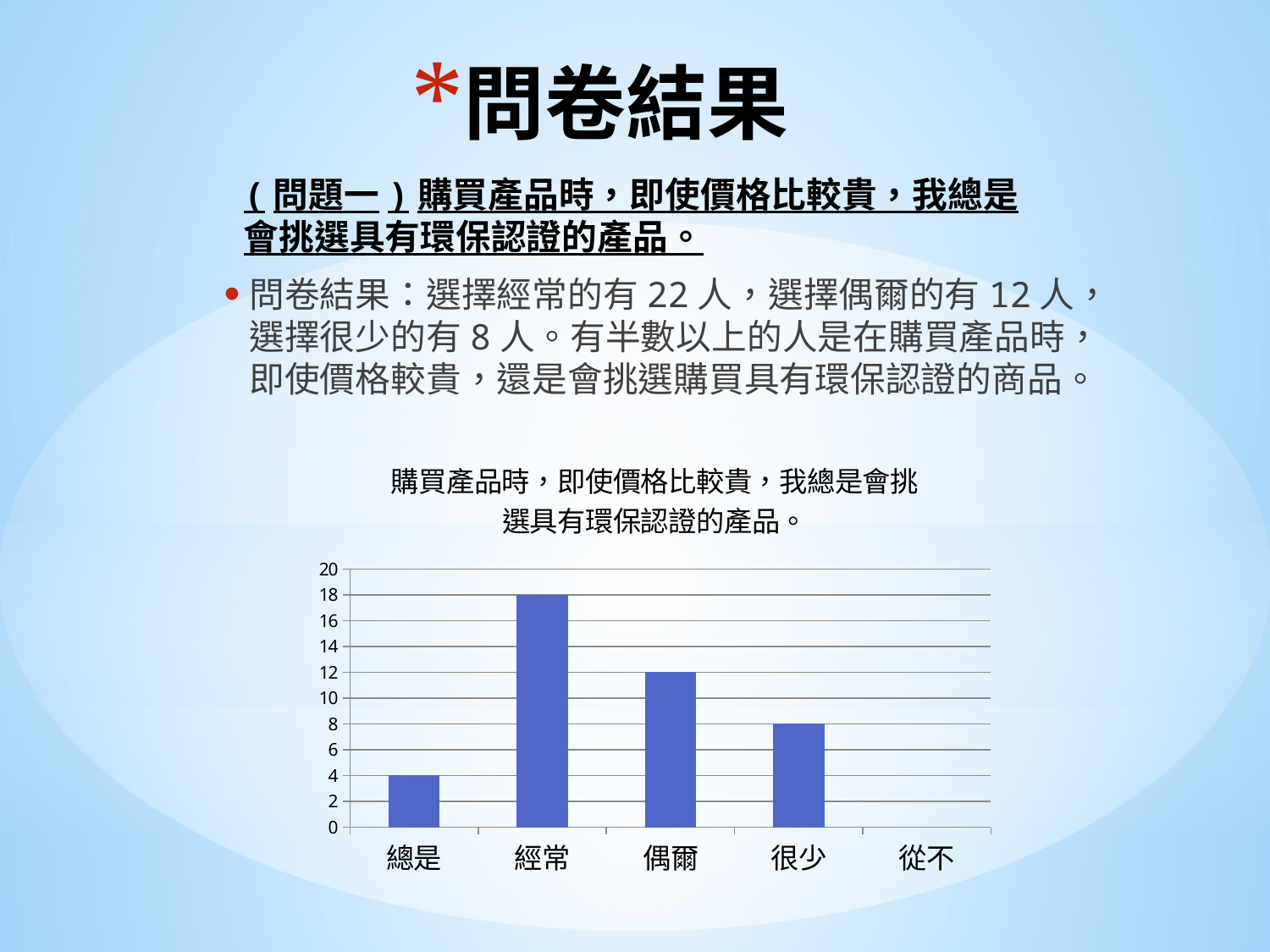
Which category has the highest value in the chart? 經常 What is the value for 偶爾 in the chart? 12 What is the difference between the values for 經常 and 偶爾? 6 What is the highest value shown on the chart's vertical axis? 20 What is the value for 總是 in the chart? 4 What is the value for 經常 in the chart? 18 What is the value for 很少 in the chart? 8 What kind of chart is shown on the slide? bar chart Which is larger, the value for 偶爾 or the value for 很少? 偶爾 Which category has the lowest value in the chart? 從不 How many categories are shown on the x axis of the chart? 5 Is the value for 經常 greater or less than 10? greater